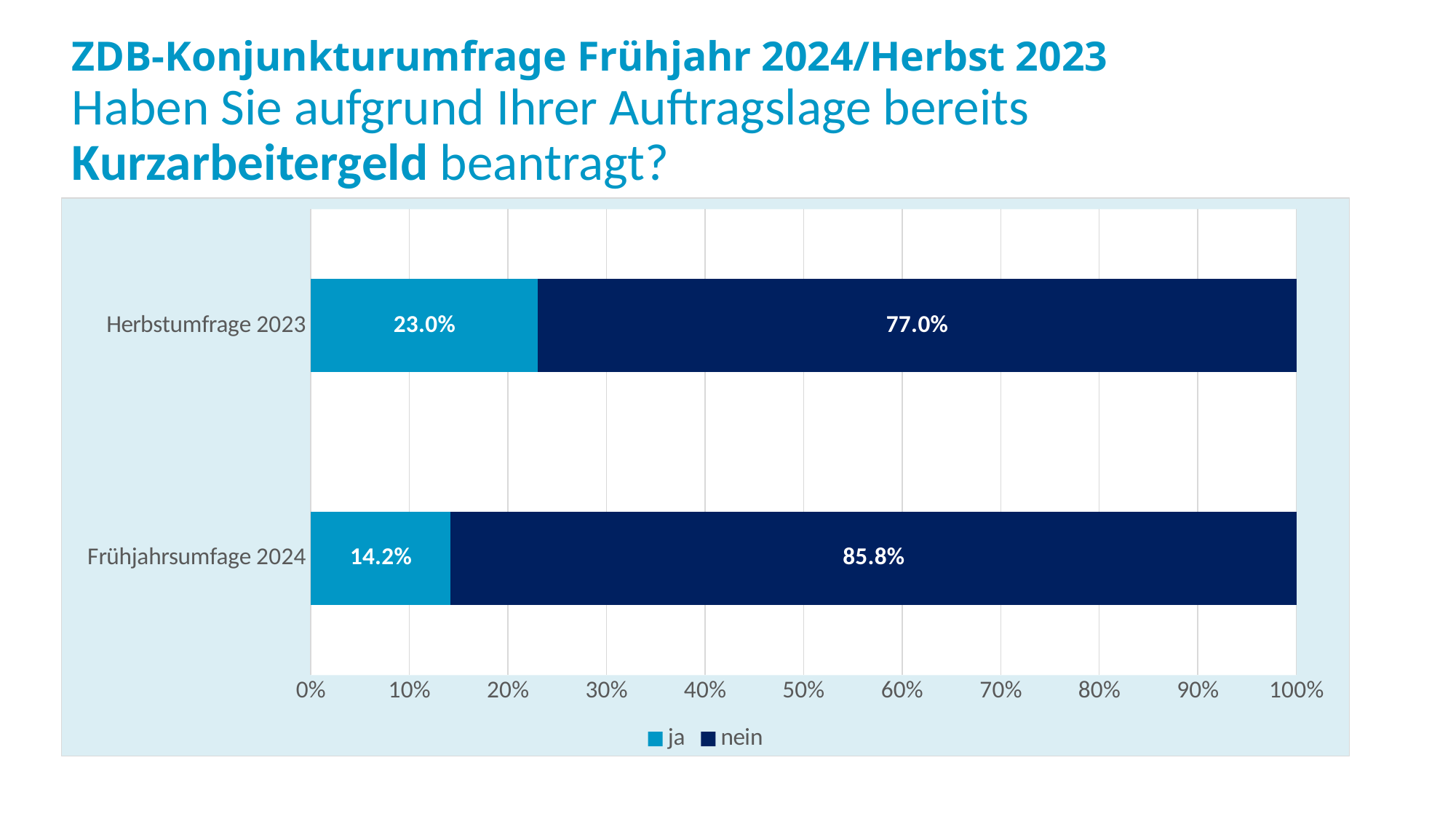
Which survey has the higher share of "ja" answers? Herbstumfrage 2023 What is the difference between the "ja" values of Herbstumfrage 2023 and Frühjahrsumfage 2024? 8.8% Is the "nein" value for Frühjahrsumfage 2024 larger than the "nein" value for Herbstumfrage 2023? Yes How many categories (surveys) are shown on the chart? 2 What is the value for "ja" in Frühjahrsumfage 2024? 14.2% How many series does the legend list? 2 Which survey has the lower share of "nein" answers? Herbstumfrage 2023 What kind of chart is shown on the slide? Stacked bar chart Is the "ja" value for Frühjahrsumfage 2024 greater or less than 20%? less What is the value for "ja" in Herbstumfrage 2023? 23.0% What is the value for "nein" in Frühjahrsumfage 2024? 85.8% What is the value for "nein" in Herbstumfrage 2023? 77.0%